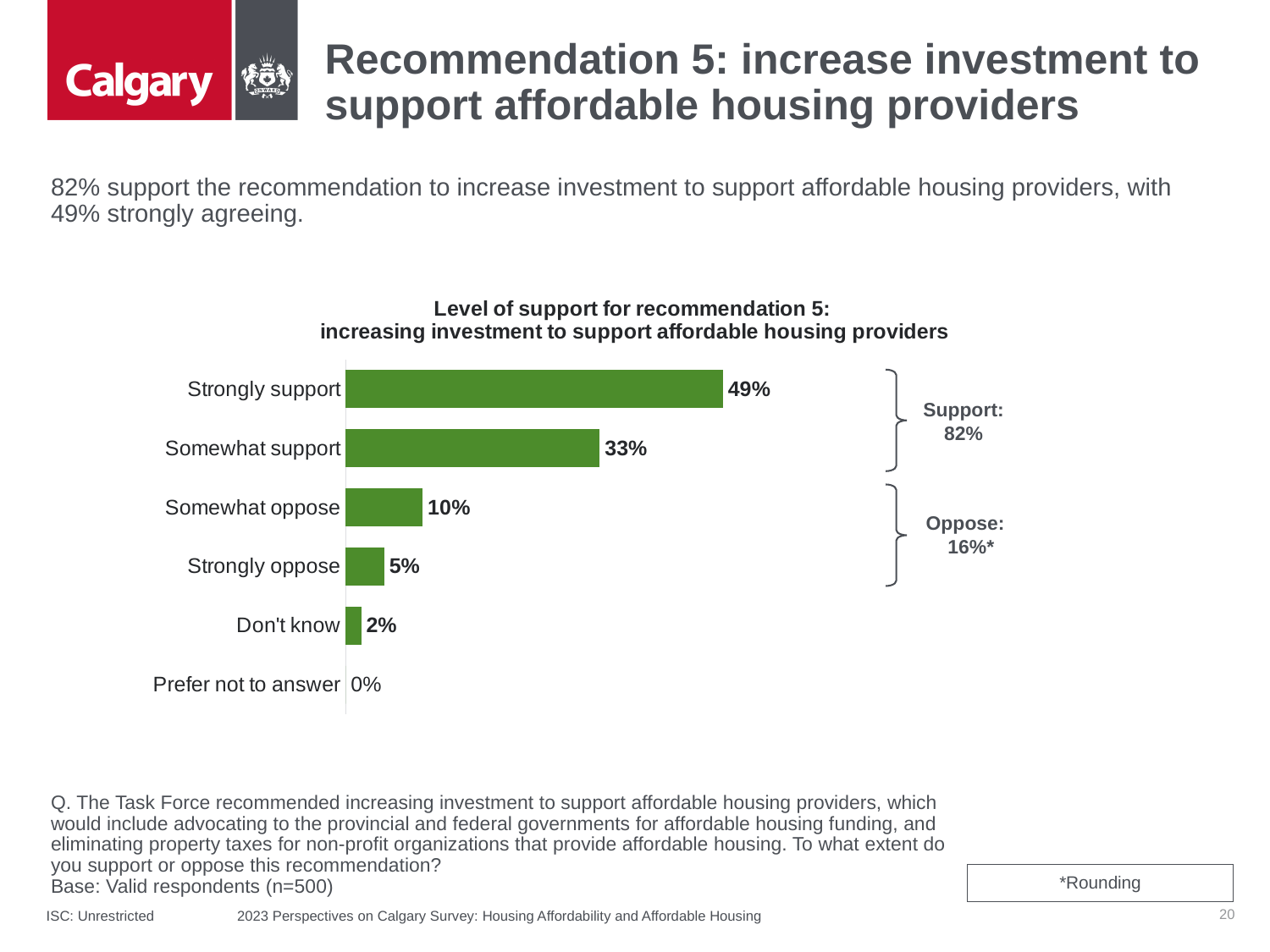
Which category has the lowest value? Prefer not to answer What is the value for Somewhat support? 33% What kind of chart is shown? Bar chart Which is larger, Somewhat support or Somewhat oppose? Somewhat support How many categories are shown in the chart? 6 What is the difference between Strongly support and Somewhat support? 16 percentage points What combined Oppose percentage is shown beside the chart? 16%* Which category has the highest value? Strongly support What is the value for Somewhat oppose? 10% What is the value for Don't know? 2% What is the difference between Somewhat oppose and Strongly oppose? 5 percentage points What percentage of respondents strongly support recommendation 5? 49%